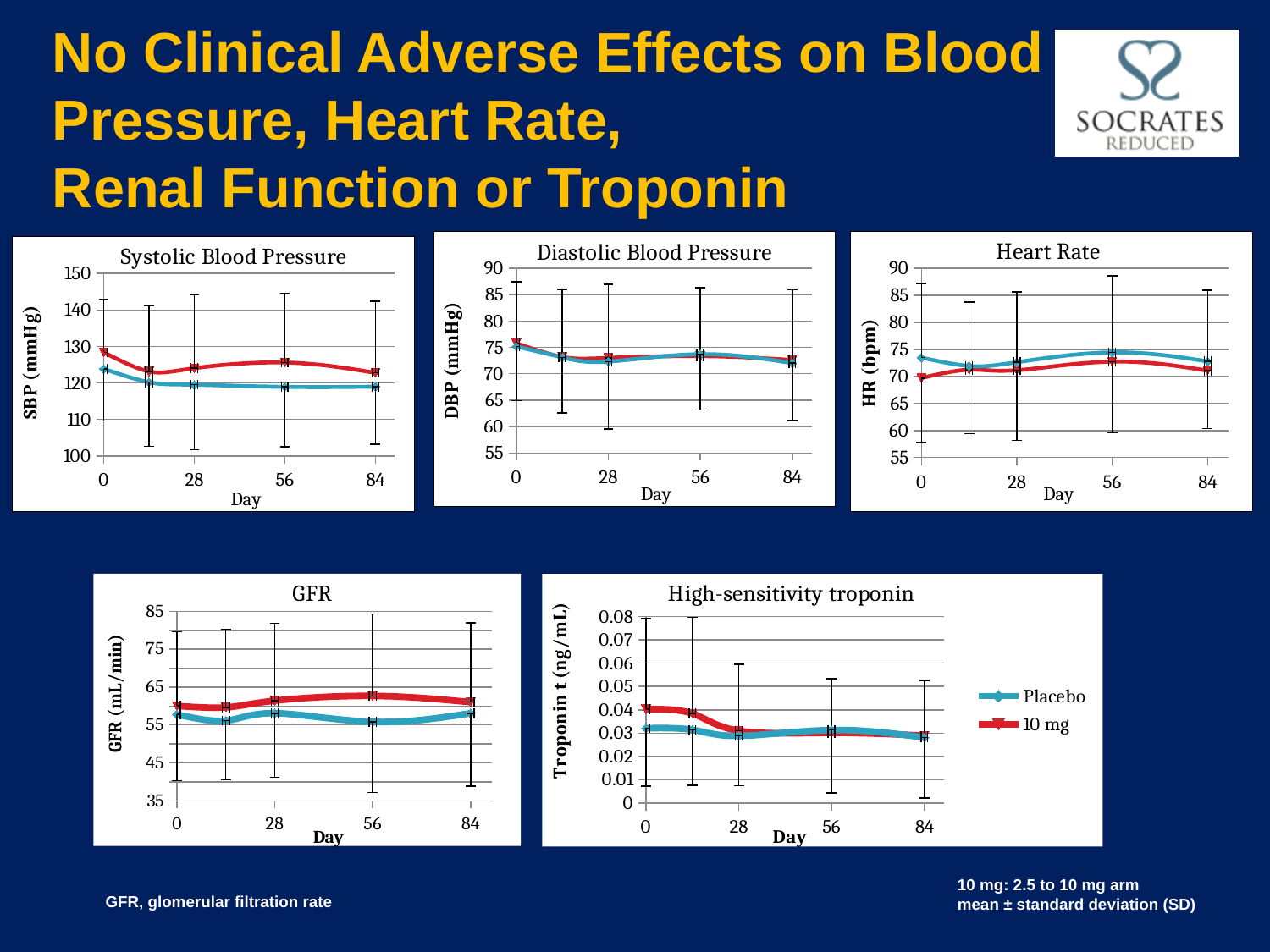
How many series does the legend list for the charts on the slide? 2 In the GFR chart, is the Placebo value at day 56 greater or less than 65? less In the Diastolic Blood Pressure chart, is the 10 mg value at day 0 greater or less than 80? less What is the y-axis label of the High-sensitivity troponin chart? Troponin t (ng/mL) What kind of chart is the Systolic Blood Pressure chart? Line chart In the Systolic Blood Pressure chart, is the Placebo value at day 0 greater or less than 120? greater In the Systolic Blood Pressure chart, does the Placebo series rise or fall from day 0 to day 84? Fall In the High-sensitivity troponin chart, which series has the higher value at day 0, Placebo or 10 mg? 10 mg How many labelled tick values are shown on the Day axis of the GFR chart? 4 In the Heart Rate chart, which series has the higher value at day 0, Placebo or 10 mg? Placebo In the Systolic Blood Pressure chart, which series has the higher value at day 56, Placebo or 10 mg? 10 mg